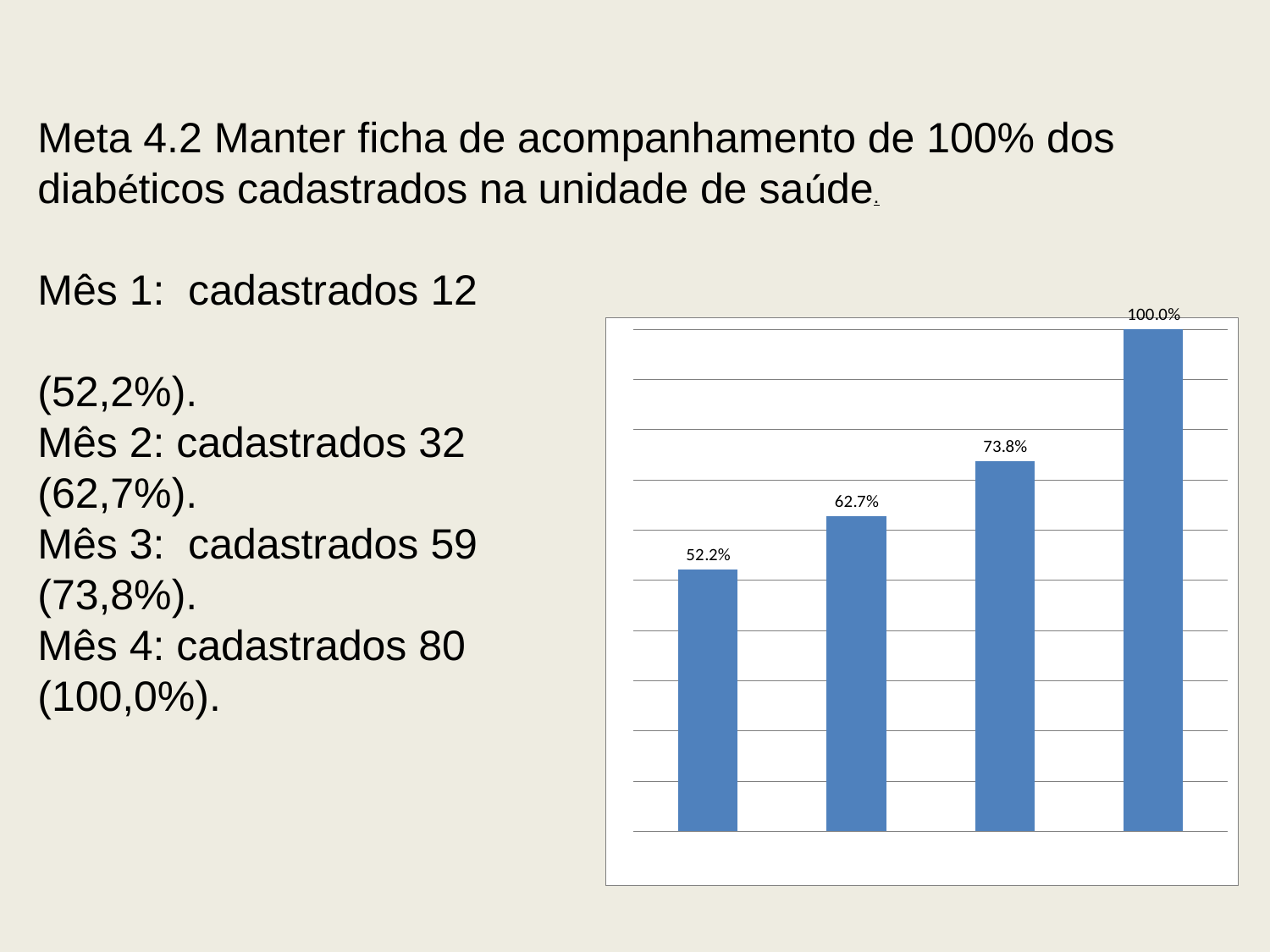
Which is larger in the chart, the second bar or the third bar? The third bar (73.8%) Which bar in the chart has the lowest value? The first (leftmost) bar, 52.2% What is the difference between the third bar and the second bar in the chart? 11.1% What value is shown on the fourth (rightmost) bar of the chart? 100.0% How many bars are plotted in the chart? 4 Do the values in the chart rise or fall from left to right? Rise What value is shown on the third bar of the chart? 73.8% What value is shown on the second bar of the chart? 62.7% What value is shown on the first (leftmost) bar of the chart? 52.2% What is the difference between the rightmost bar and the leftmost bar in the chart? 47.8% What type of chart is shown on the slide? Bar chart Which bar in the chart has the highest value? The fourth (rightmost) bar, 100.0%